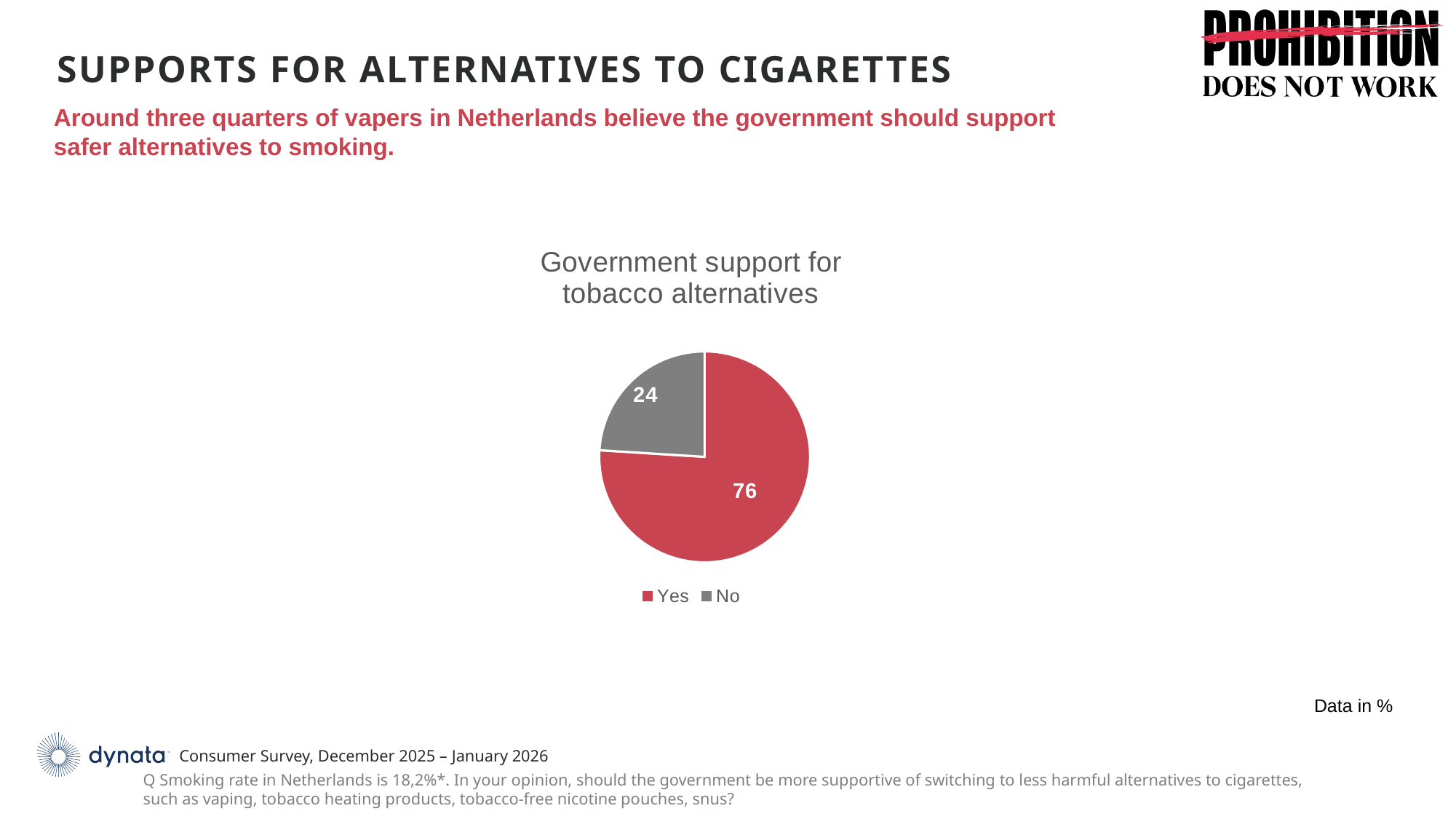
How many slices does the pie chart have? 2 How many entries does the legend of the pie chart list? 2 What is the value for No in the pie chart? 24 What colour is the Yes slice in the pie chart? red What kind of chart is shown on the slide? pie chart Which is larger in the pie chart, Yes or No? Yes Which slice of the pie chart is the largest? Yes What is the difference between the Yes and No values in the pie chart? 52 What is the value for Yes in the pie chart? 76 What is the title of the pie chart? Government support for tobacco alternatives Which slice of the pie chart is the smallest? No What share of the pie does the Yes slice represent? 76%